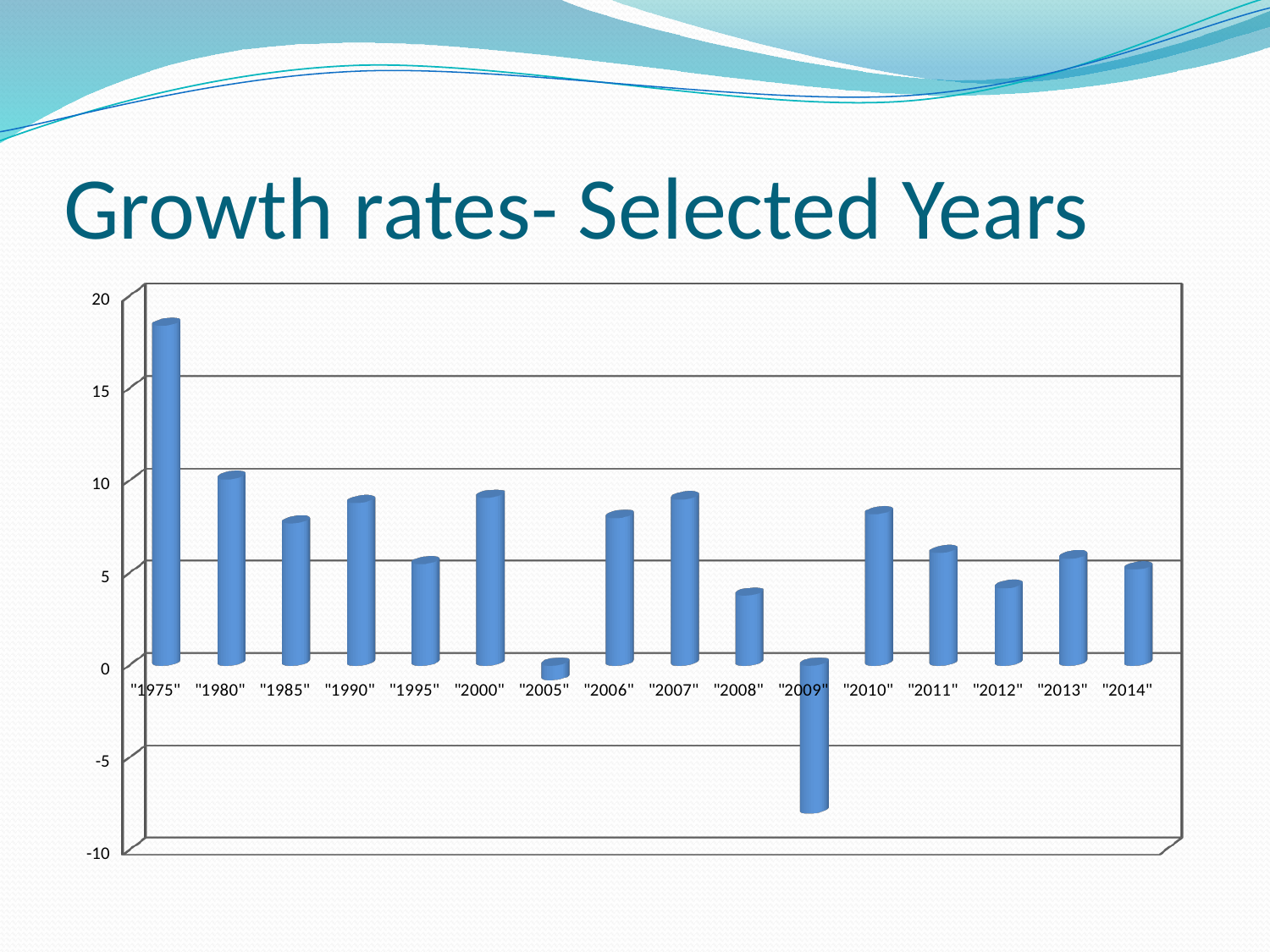
How many years are shown on the x axis of the chart? 16 Which is larger, the value for 2008 or the value for 2010? 2010 Which is larger, the value for 1975 or the value for 1980? 1975 What is the title of the chart? Growth rates- Selected Years Is the value for 1975 greater or less than 15? greater Which year has the lowest growth rate? 2009 Is the value for 2009 greater or less than -5? less How many years show a negative growth rate? 2 What kind of chart is shown on the slide? bar chart Which year has the highest growth rate? 1975 Is the value for 2008 greater or less than 5? less